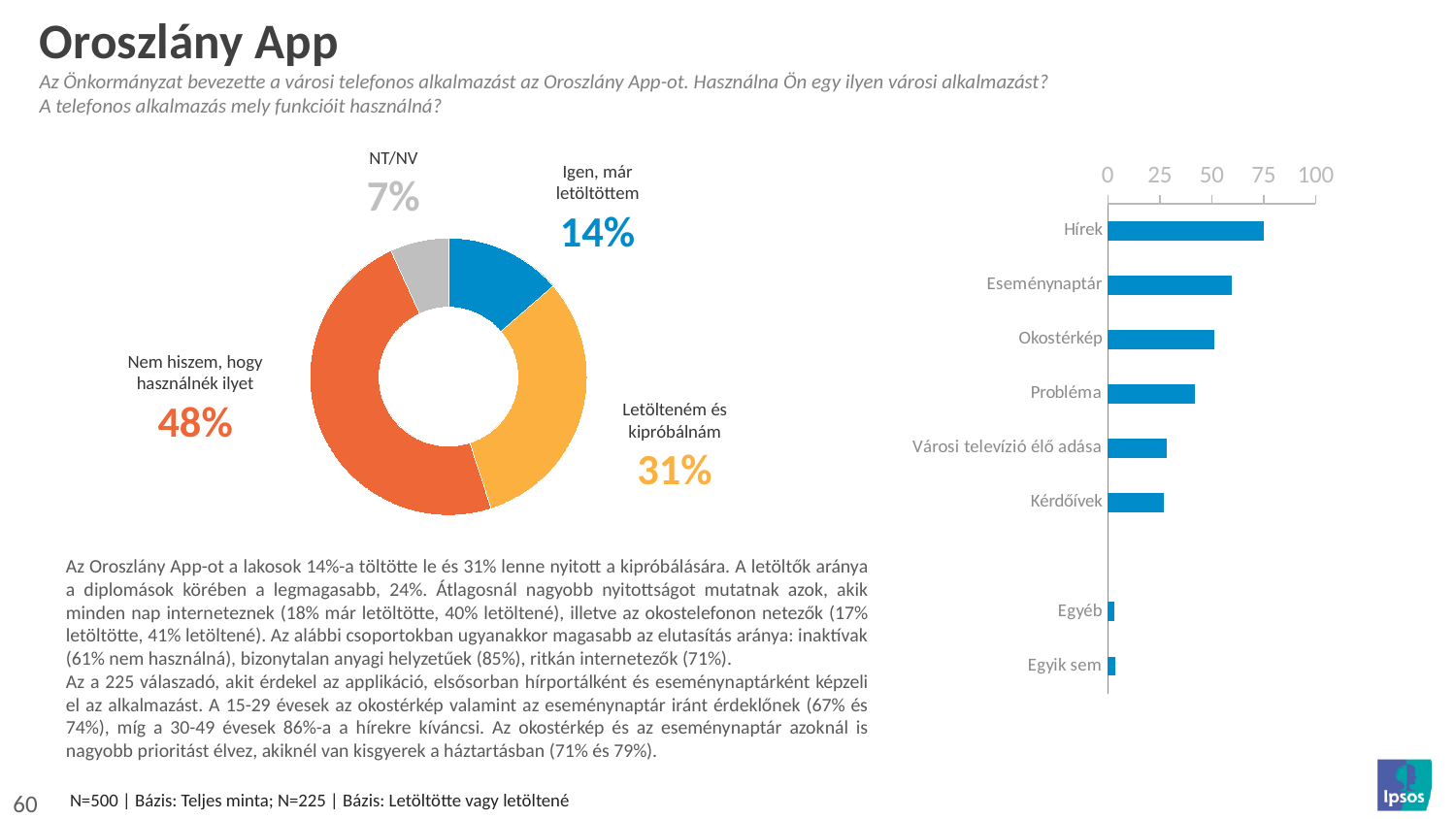
In the donut chart on the left, what percentage of respondents answered "Igen, már letöltöttem"? 14% In the donut chart on the left, which response has the smallest share? NT/NV In the donut chart on the left, what is the difference in percentage points between "Letölteném és kipróbálnám" and "Igen, már letöltöttem"? 17 In the bar chart on the right, which function has the highest value? Hírek In the donut chart on the left, what percentage of respondents answered "Nem hiszem, hogy használnék ilyet"? 48% In the bar chart on the right, is the value for Probléma greater or less than 50? less In the donut chart on the left, what percentage of respondents answered "Letölteném és kipróbálnám"? 31% What kind of chart is shown on the right side of the slide? Bar chart In the bar chart on the right, is the value for Hírek greater or less than 50? greater In the donut chart on the left, which response has the largest share? Nem hiszem, hogy használnék ilyet In the bar chart on the right, which is larger, the value for Eseménynaptár or the value for Kérdőívek? Eseménynaptár In the donut chart on the left, how many response categories are shown? 4